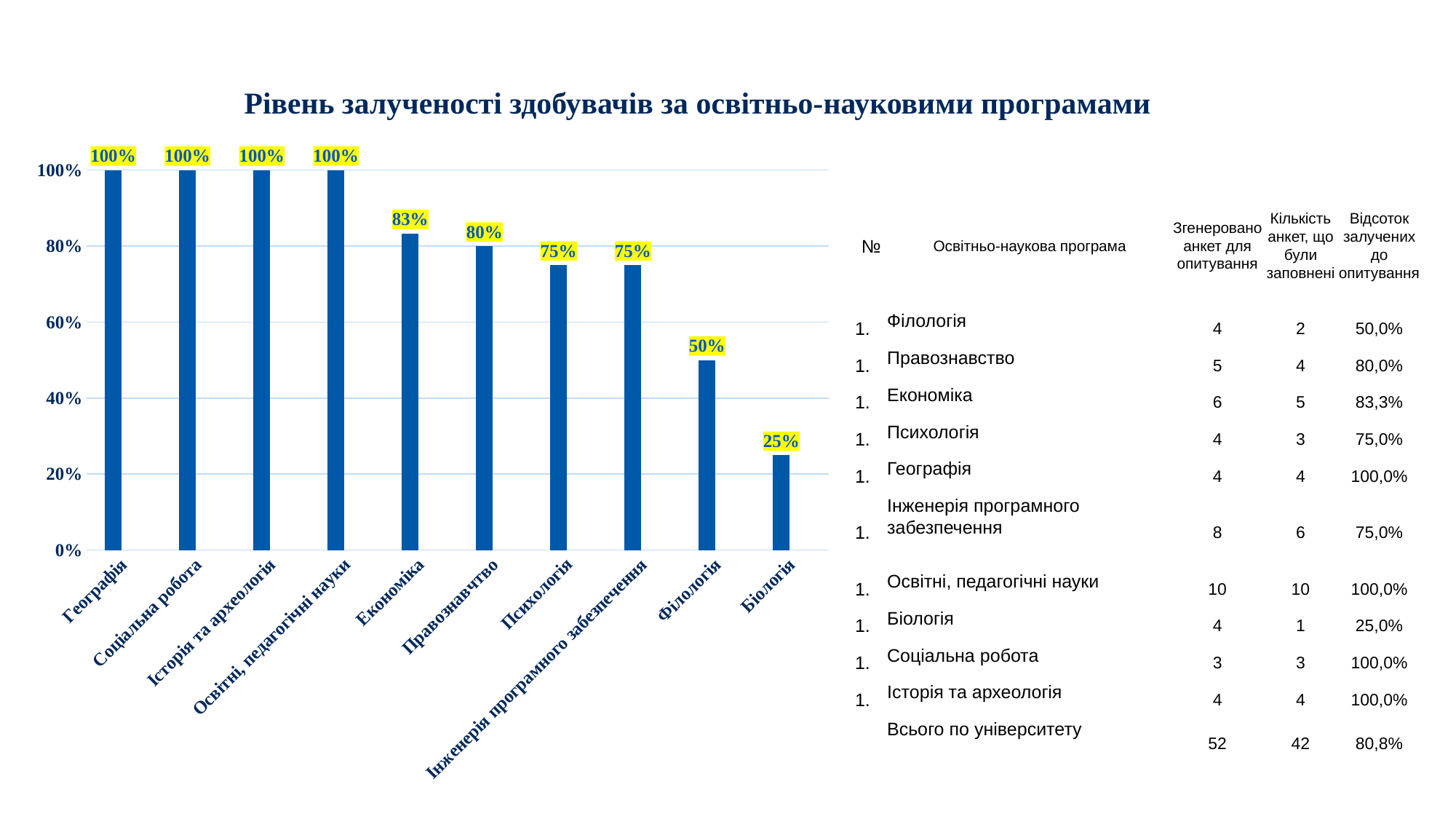
What is the value for Правознавство? 80% What is the value for Філологія? 50% How many categories are shown on the x axis? 10 Which is larger, the value for Психологія or the value for Філологія? Психологія What kind of chart is shown on the slide? bar chart What is the difference between the values for Правознавство and Філологія? 30% What is the value for Економіка? 83% What is the difference between the values for Економіка and Біологія? 58% Is the value for Інженерія програмного забезпечення greater or less than 60%? greater Which category has the lowest value? Біологія What is the title of the chart? Рівень залученості здобувачів за освітньо-науковими програмами Do the values rise or fall from left to right along the x axis? fall